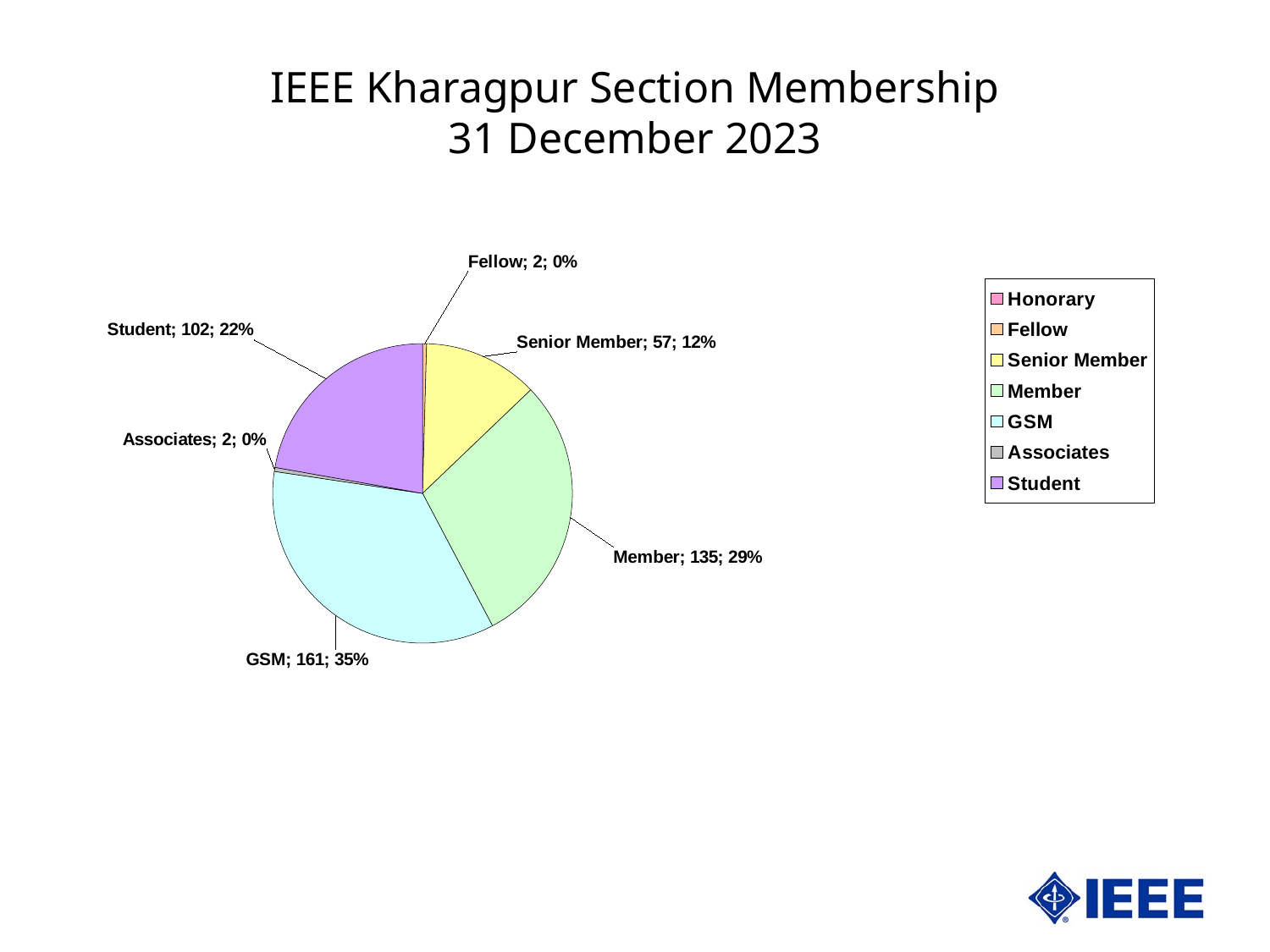
Which is larger, the Student slice or the Senior Member slice? Student How many members does the GSM slice represent? 161 Which membership category has the largest slice of the pie? GSM How many entries does the legend list? 7 What type of chart is shown on the slide? pie chart What is the difference between the number of GSM members and the number of Members? 26 What is the difference between the number of Members and the number of Student members? 33 How many Fellows are shown in the pie chart? 2 What share of the pie does the Member category hold? 29% What percentage of the membership is Student? 22% What is the title of the chart on the slide? IEEE Kharagpur Section Membership 31 December 2023 How many Senior Members are shown in the pie chart? 57